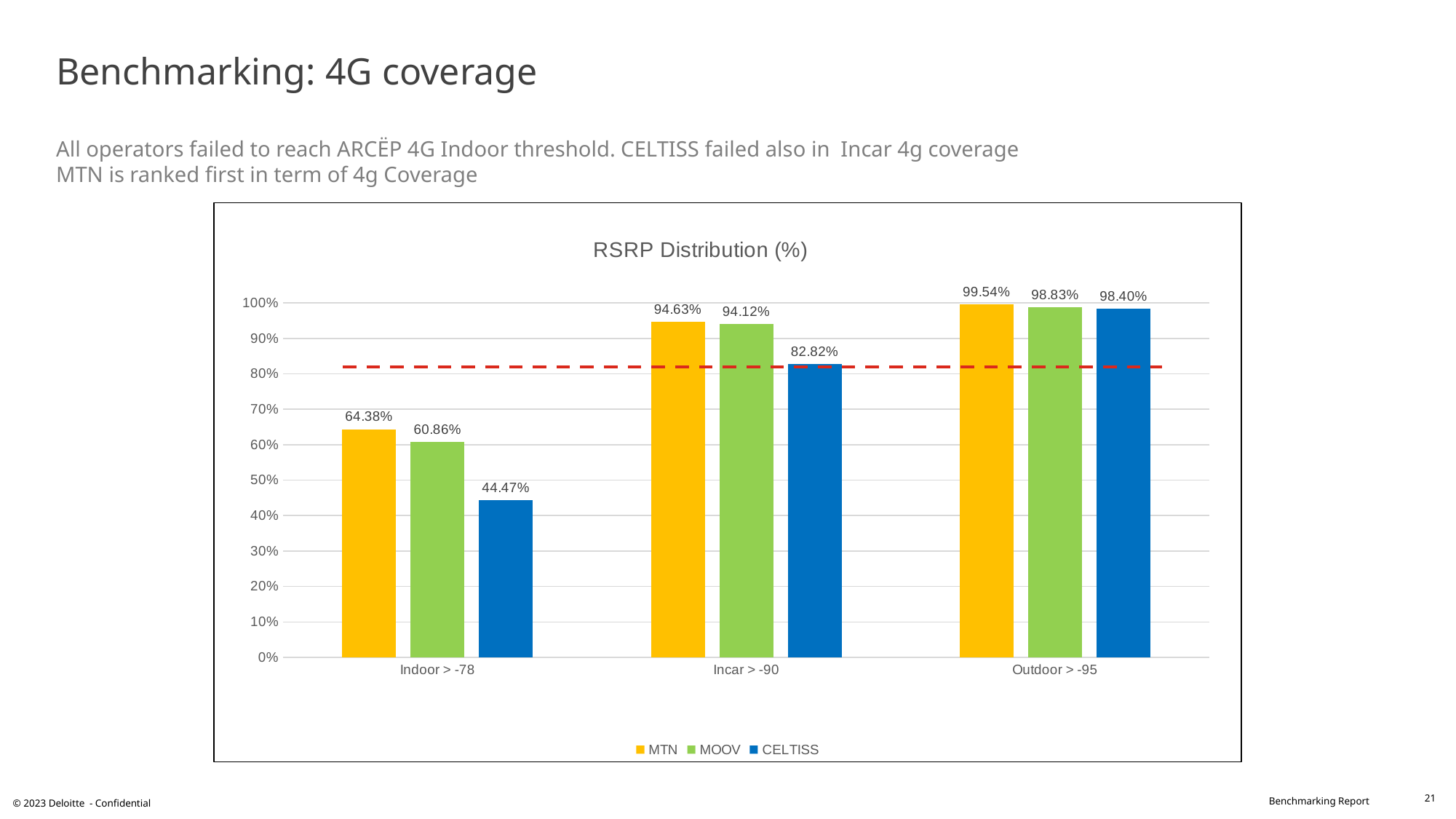
What is the value for MOOV in the Outdoor > -95 category? 98.83% What is the title of the chart? RSRP Distribution (%) Which is larger in the Incar > -90 category: MTN or MOOV? MTN What is the value for MTN in the Indoor > -78 category? 64.38% How many series does the legend list? 3 What is the difference between MTN and CELTISS in the Indoor > -78 category? 19.91% Which operator has the lowest value in the Indoor > -78 category? CELTISS Which operator has the highest value in the Outdoor > -95 category? MTN Is the value for CELTISS in the Indoor > -78 category greater or less than 50%? less What kind of chart is shown on the slide? Bar chart What is the value for CELTISS in the Incar > -90 category? 82.82% How many categories are shown on the x axis? 3